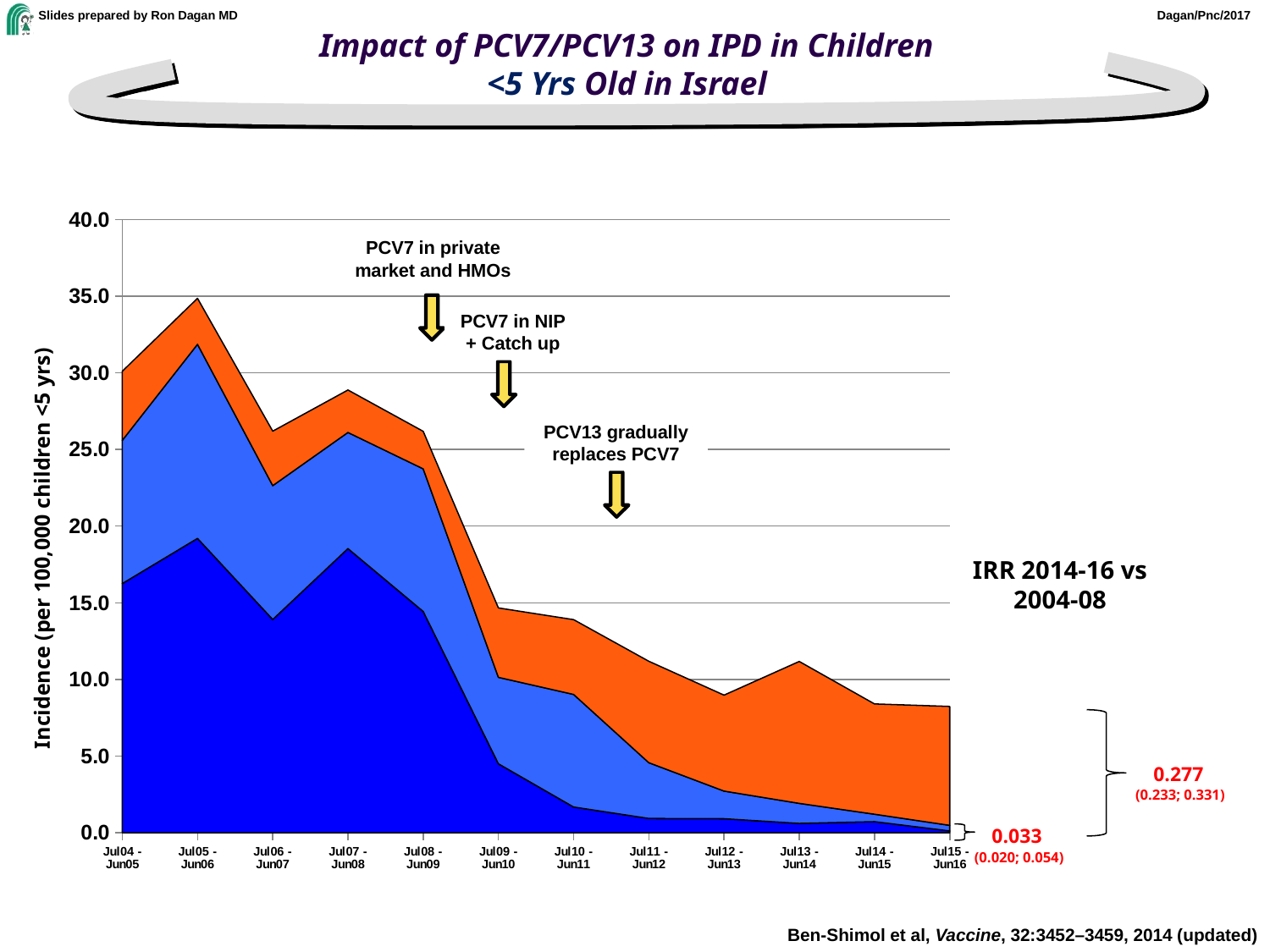
Is the total incidence for Jul09 - Jun10 greater or less than 20.0? less Is the total incidence for Jul05 - Jun06 greater or less than 30.0? greater How many time periods are shown along the x axis? 12 What is the label of the y axis? Incidence (per 100,000 children <5 yrs) Overall, does the total incidence rise or fall from Jul04 - Jun05 to Jul15 - Jun16? Fall What kind of chart is shown on the slide? Stacked area chart Is the total incidence for Jul15 - Jun16 greater or less than 10.0? less Which period has the larger total incidence, Jul06 - Jun07 or Jul07 - Jun08? Jul07 - Jun08 What IRR value (2014-16 vs 2004-08) is shown next to the upper bracket on the right of the chart? 0.277 Which period has the highest total incidence? Jul05 - Jun06